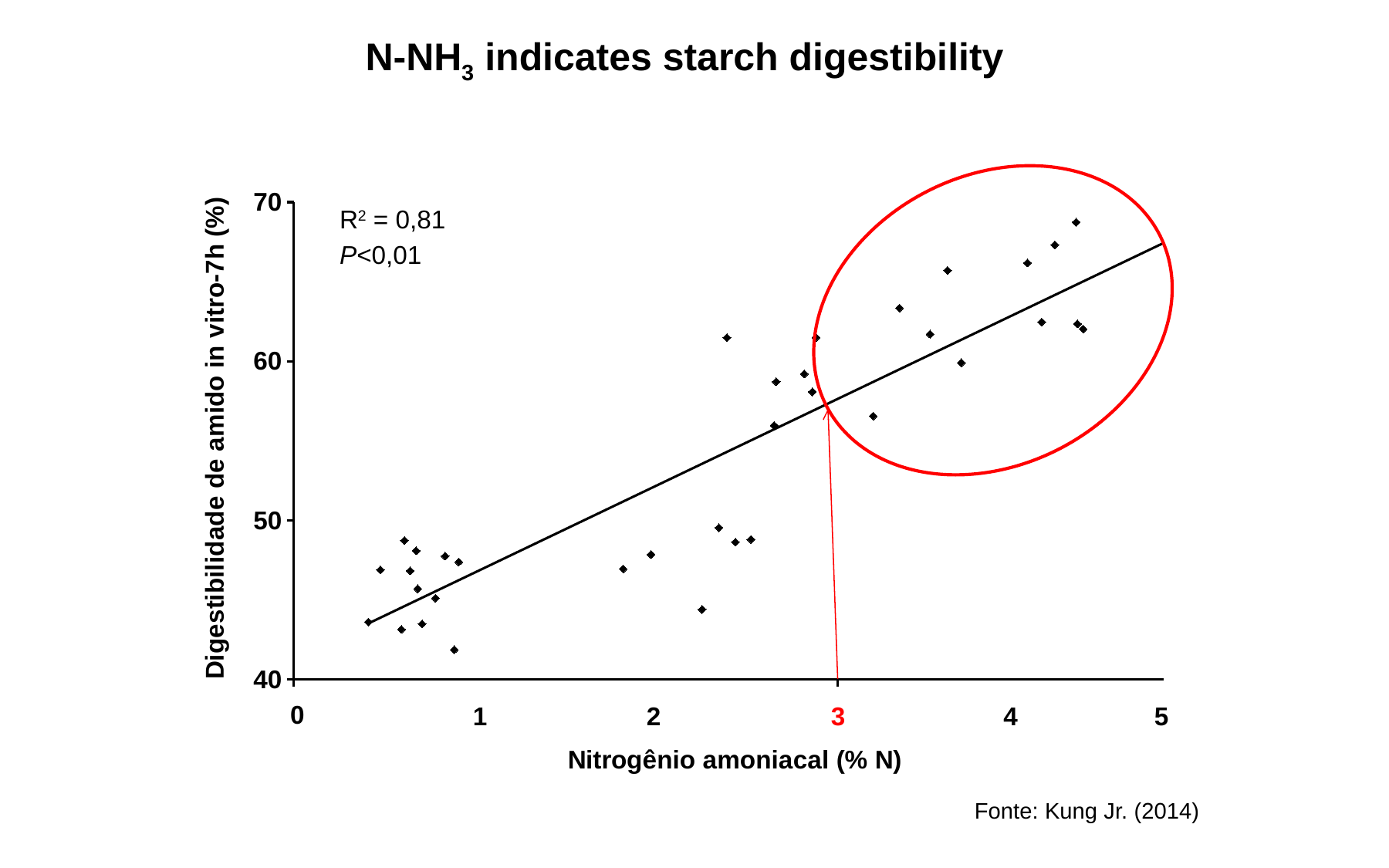
Are the data points with ammoniacal nitrogen below 1 % N greater or less than 55 on the y axis? less Is the highest plotted point on the chart greater or less than 60 on the y axis? greater Which x-axis tick value is highlighted in red on the chart? 3 What R² value is printed on the chart? R² = 0,81 Is the lowest plotted point on the chart greater or less than 50 on the y axis? less What kind of chart is shown on the slide? scatter plot Do the plotted values of starch digestibility rise or fall as ammoniacal nitrogen increases along the x axis? rise